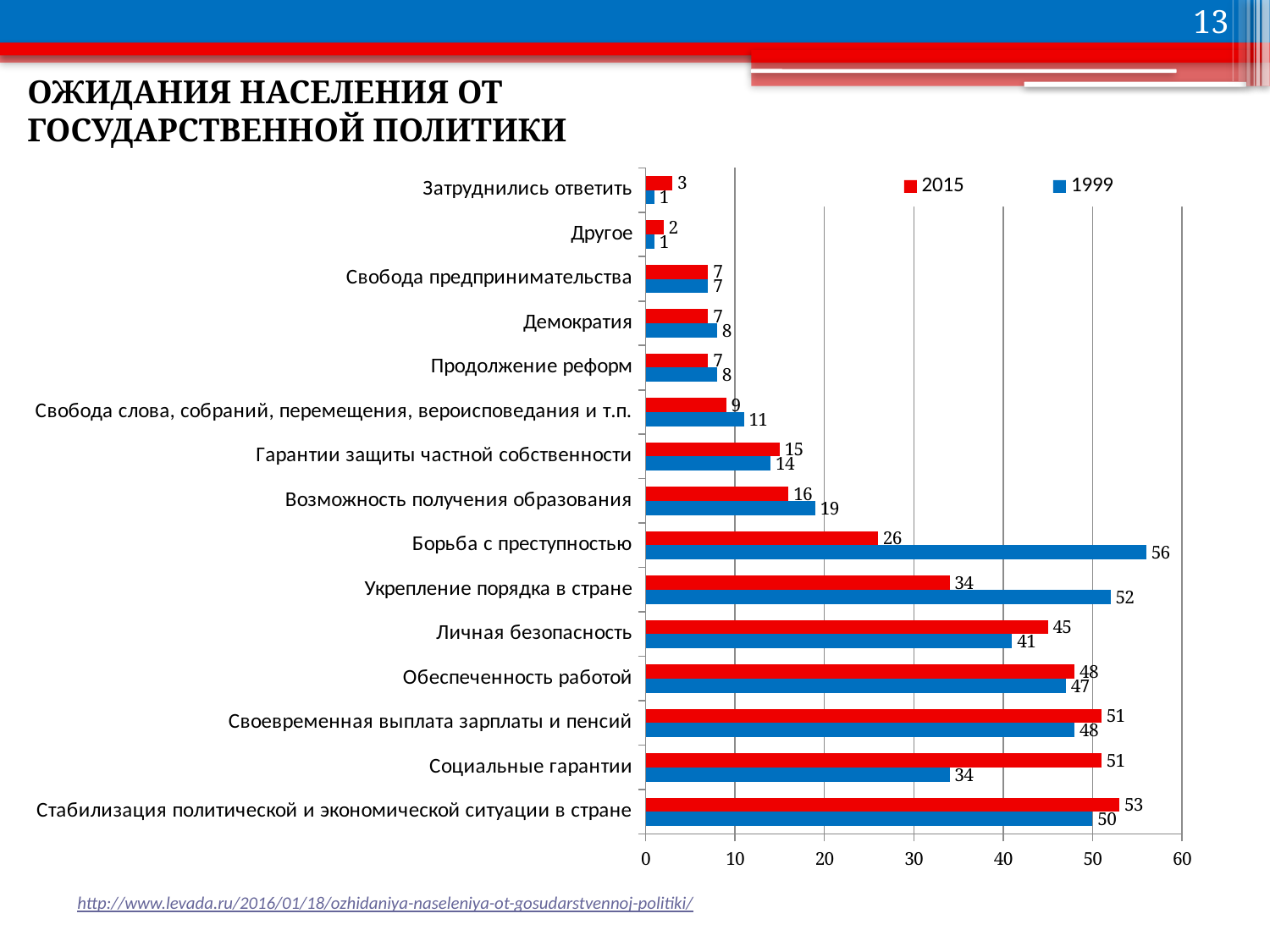
Which series is shown in red in the legend? 2015 How many categories are shown on the chart? 15 What is the difference between the 1999 and 2015 values for Борьба с преступностью? 30 Which is larger for Личная безопасность, the 2015 value or the 1999 value? 2015 What is the 1999 value for Социальные гарантии? 34 Which category has the highest 2015 value? Стабилизация политической и экономической ситуации в стране What is the 1999 value for Укрепление порядка в стране? 52 What is the 2015 value for Борьба с преступностью? 26 How many series does the legend list? 2 Which category has the lowest 2015 value? Другое Which category has the highest 1999 value? Борьба с преступностью What type of chart is shown on the slide? bar chart